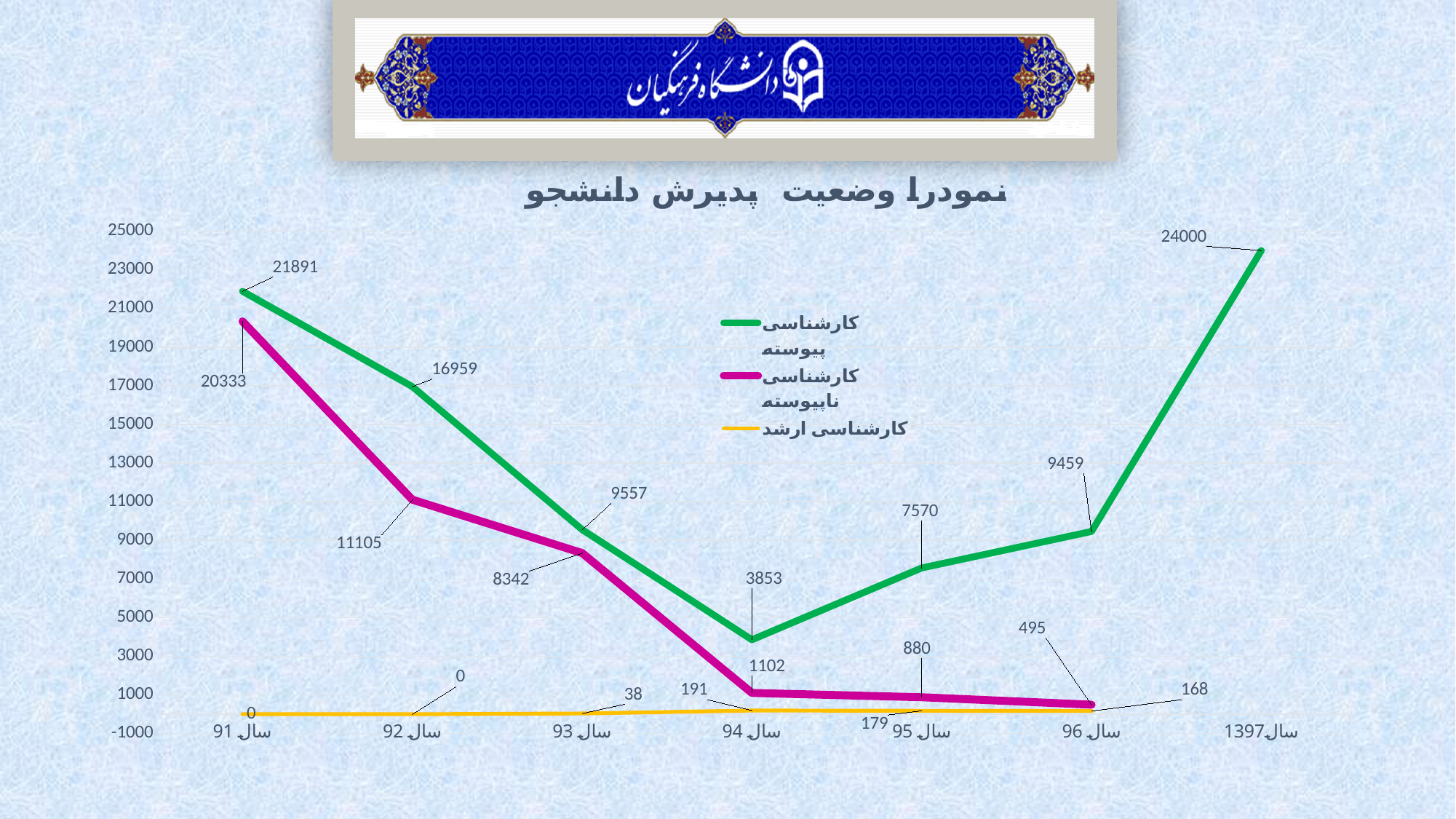
In which year is کارشناسی پیوسته at its lowest? سال 94 Does کارشناسی ناپیوسته rise or fall from سال 91 to سال 96? fall What is the title of the chart? نمودرا وضعیت پدیرش دانشجو What is the value of کارشناسی ارشد in سال 94? 191 What type of chart is shown on the slide? line chart How many series does the legend list? 3 In which year is کارشناسی ناپیوسته at its highest? سال 91 Which is larger in سال 95: کارشناسی ناپیوسته or کارشناسی ارشد? کارشناسی ناپیوسته What is the value of کارشناسی ناپیوسته in سال 92? 11105 What is the value of کارشناسی پیوسته in سال1397? 24000 What is the difference between کارشناسی پیوسته and کارشناسی ناپیوسته in سال 93? 1215 What is the value of کارشناسی پیوسته in سال 91? 21891